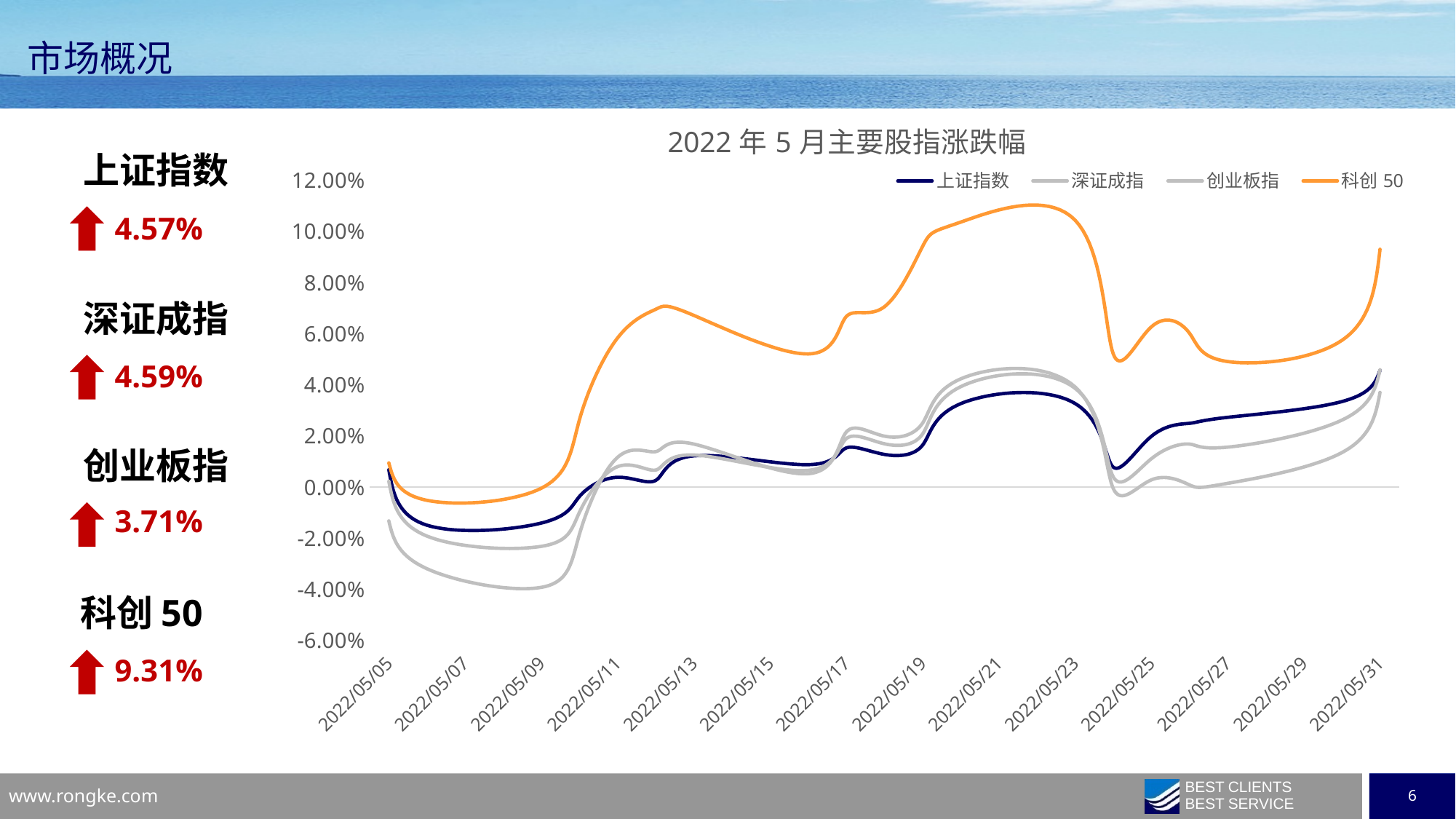
How many series does the chart legend list? 4 Does the 科创 50 line rise or fall overall from 2022/05/05 to 2022/05/31? rise How many date labels are shown on the x axis of the chart? 14 What type of chart is shown on the slide? line chart Is the value of 上证指数 on 2022/05/07 greater or less than 0.00%? less According to the figures printed on the slide, what is the May 2022 change for 科创 50? 9.31% Which series has the highest value at the end of the chart (2022/05/31)? 科创 50 Is the peak value of 科创 50 around 2022/05/21 greater or less than 10.00%? greater Is the value of 科创 50 on 2022/05/13 greater or less than 6.00%? greater What is the title of the chart? 2022 年 5 月主要股指涨跌幅 What colour is the 科创 50 line in the chart? orange According to the figures printed on the slide, what is the May 2022 change for 创业板指? 3.71%